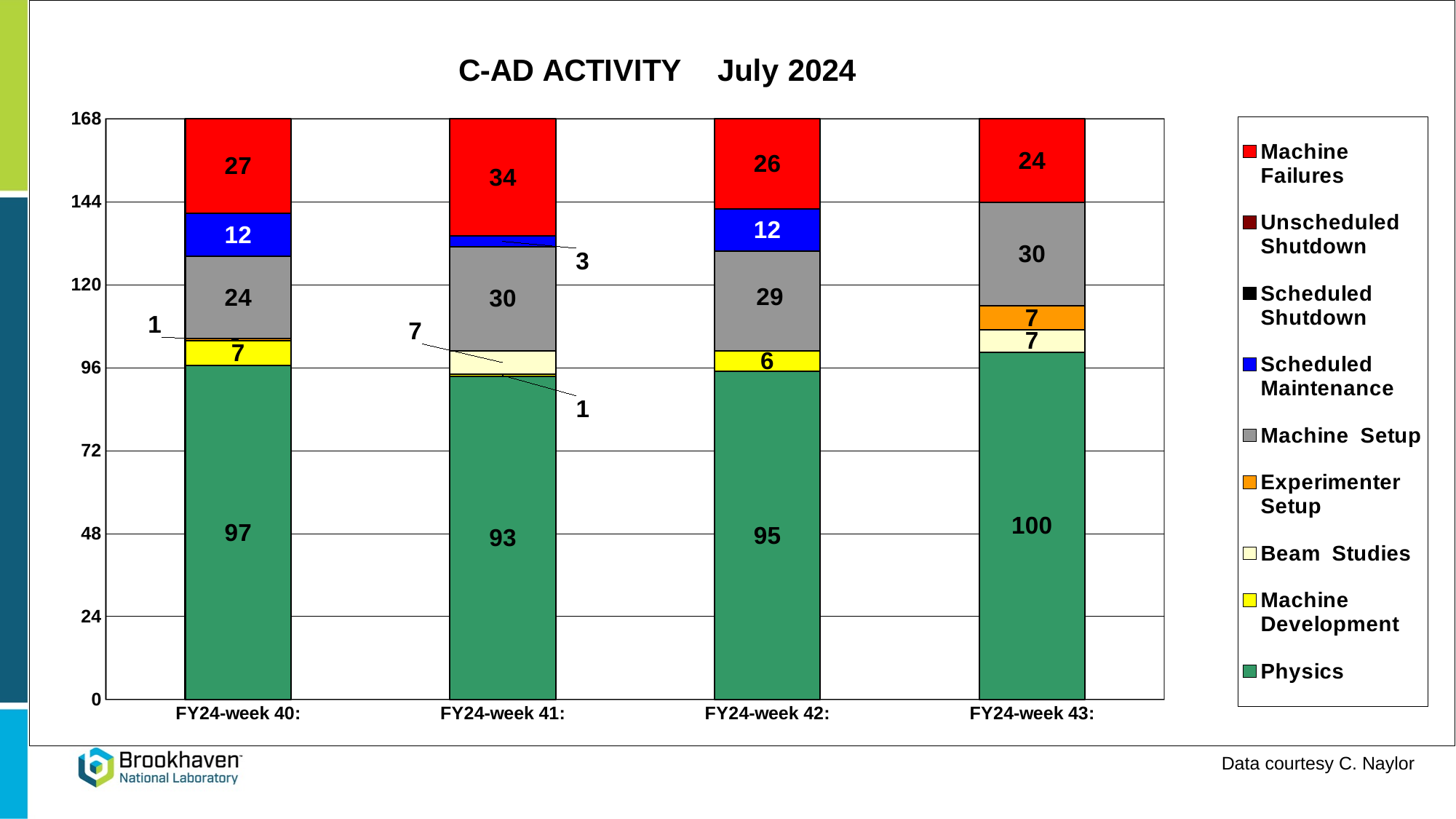
What kind of chart is shown on the slide? Stacked bar chart What is the total of the stacked bar for FY24-week 42? 168 Which week has the lowest Physics value? FY24-week 41: What is the Scheduled Maintenance value for FY24-week 42? 12 What is the Experimenter Setup value for FY24-week 43? 7 How many weeks (categories) are shown on the x axis? 4 What is the difference between the Machine Failures values for FY24-week 41 and FY24-week 43? 10 What is the Physics value for FY24-week 43? 100 What is the Machine Failures value for FY24-week 41? 34 Which week has the highest Machine Failures value? FY24-week 41: Which is larger, the Machine Setup value for FY24-week 41 or for FY24-week 42? FY24-week 41: How many series does the legend list? 9